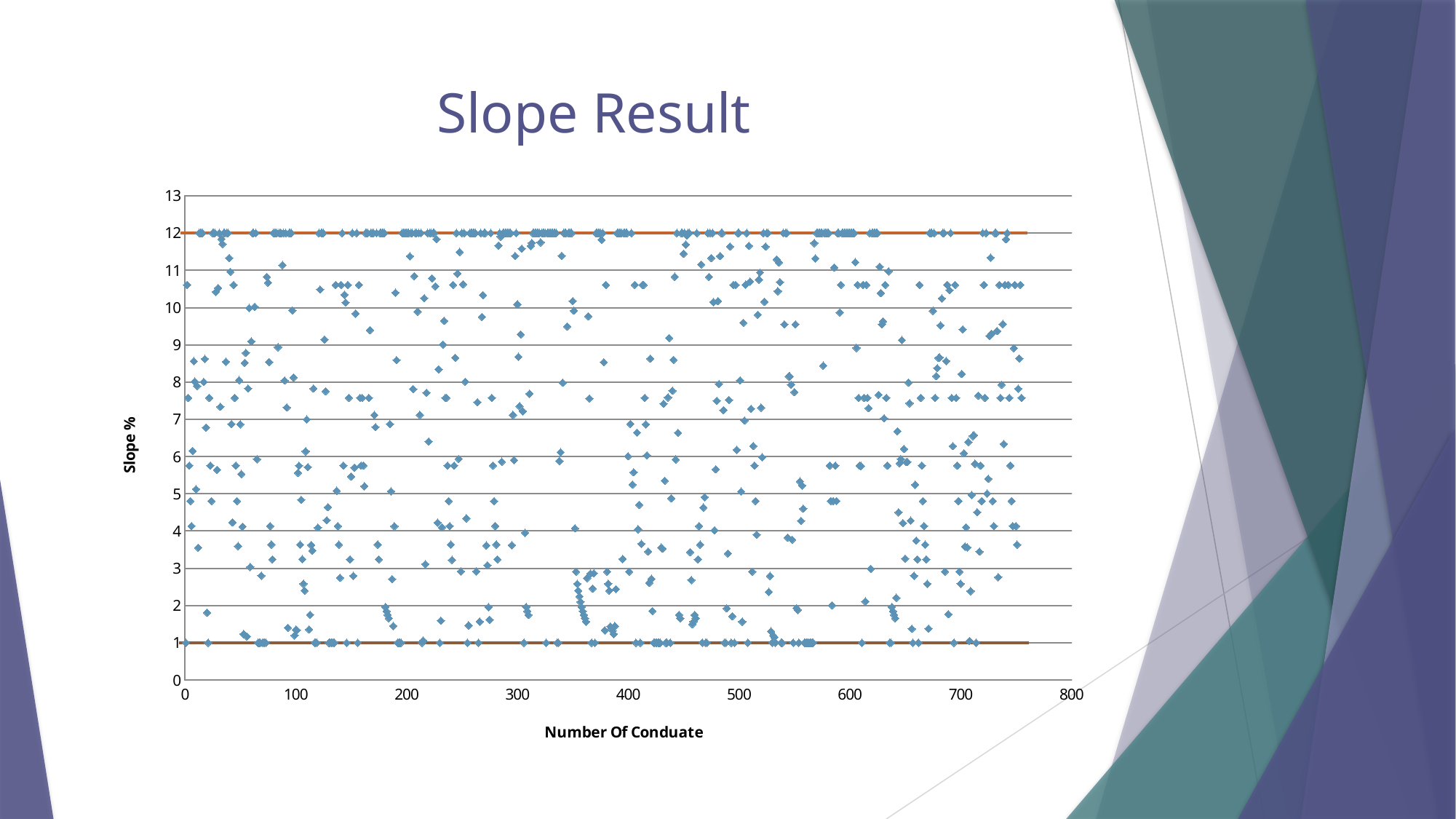
What is the highest value shown on the horizontal axis? 800 Do any of the plotted points have a Slope % value less than 1? no Do the plotted points extend beyond 800 on the horizontal axis? no At what Slope % value is the lower orange horizontal line drawn? 1 What is the label of the vertical axis? Slope % Do any of the plotted points have a Slope % value greater than 12? no What is the highest value shown on the vertical axis? 13 What is the title of the chart? Slope Result At what Slope % value is the upper orange horizontal line drawn? 12 What kind of chart is shown on the slide? scatter chart What is the interval between consecutive tick marks on the horizontal axis? 100 What is the difference between the Slope % values of the upper and lower orange horizontal lines? 11